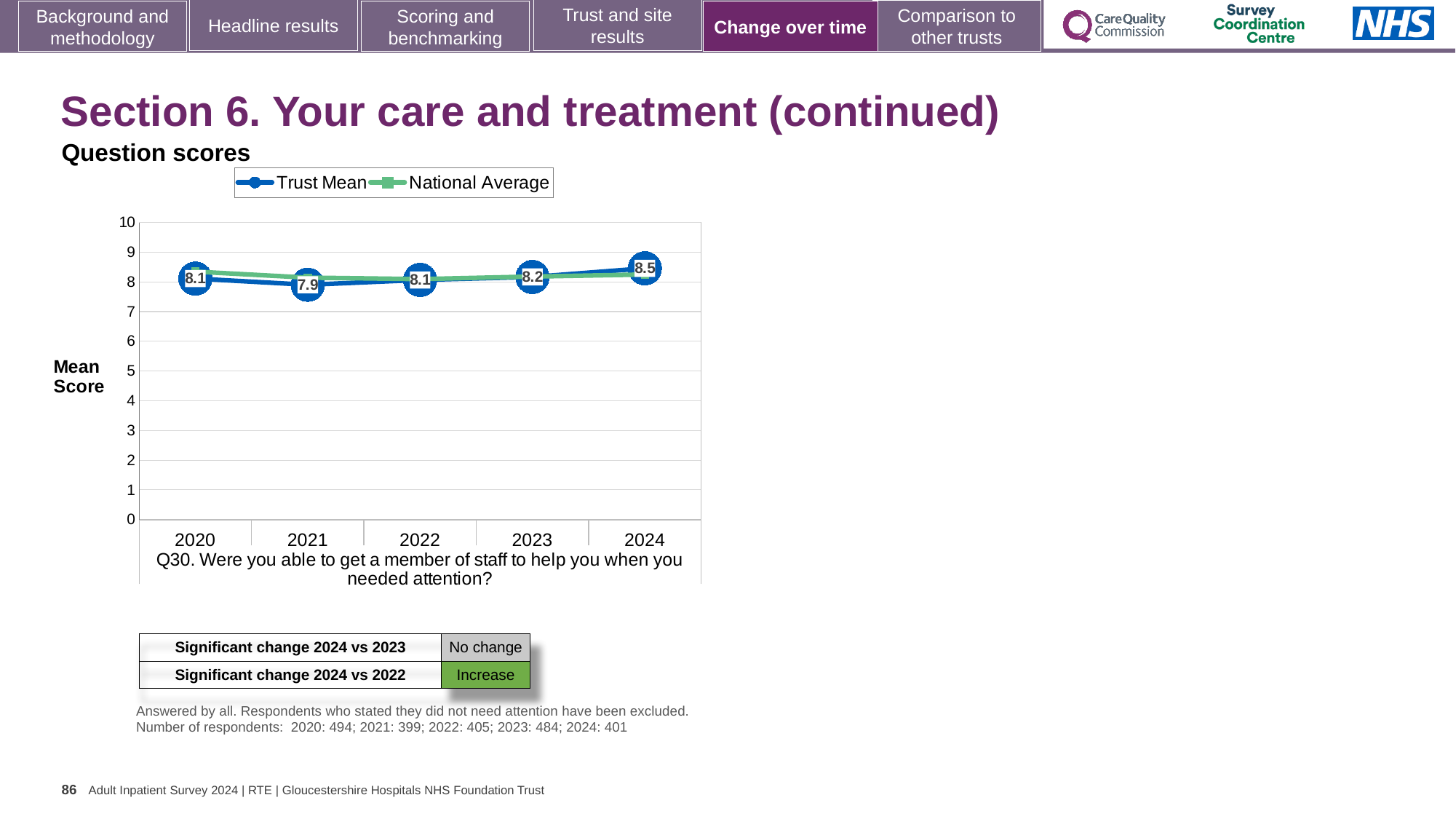
Does the Trust Mean score rise or fall from 2021 to 2024? Rise What is the difference between the Trust Mean scores for 2024 and 2021? 0.6 Is the National Average value for 2024 greater or less than 7? greater In which year is the Trust Mean score highest? 2024 Which year has the larger Trust Mean score, 2020 or 2024? 2024 What is the Trust Mean score for 2021? 7.9 How many years are shown on the x axis of the chart? 5 How many series does the chart legend list? 2 In which year is the Trust Mean score lowest? 2021 What is the Trust Mean score for 2024? 8.5 What kind of chart is shown on the slide? Line chart What is the Trust Mean score for 2023? 8.2